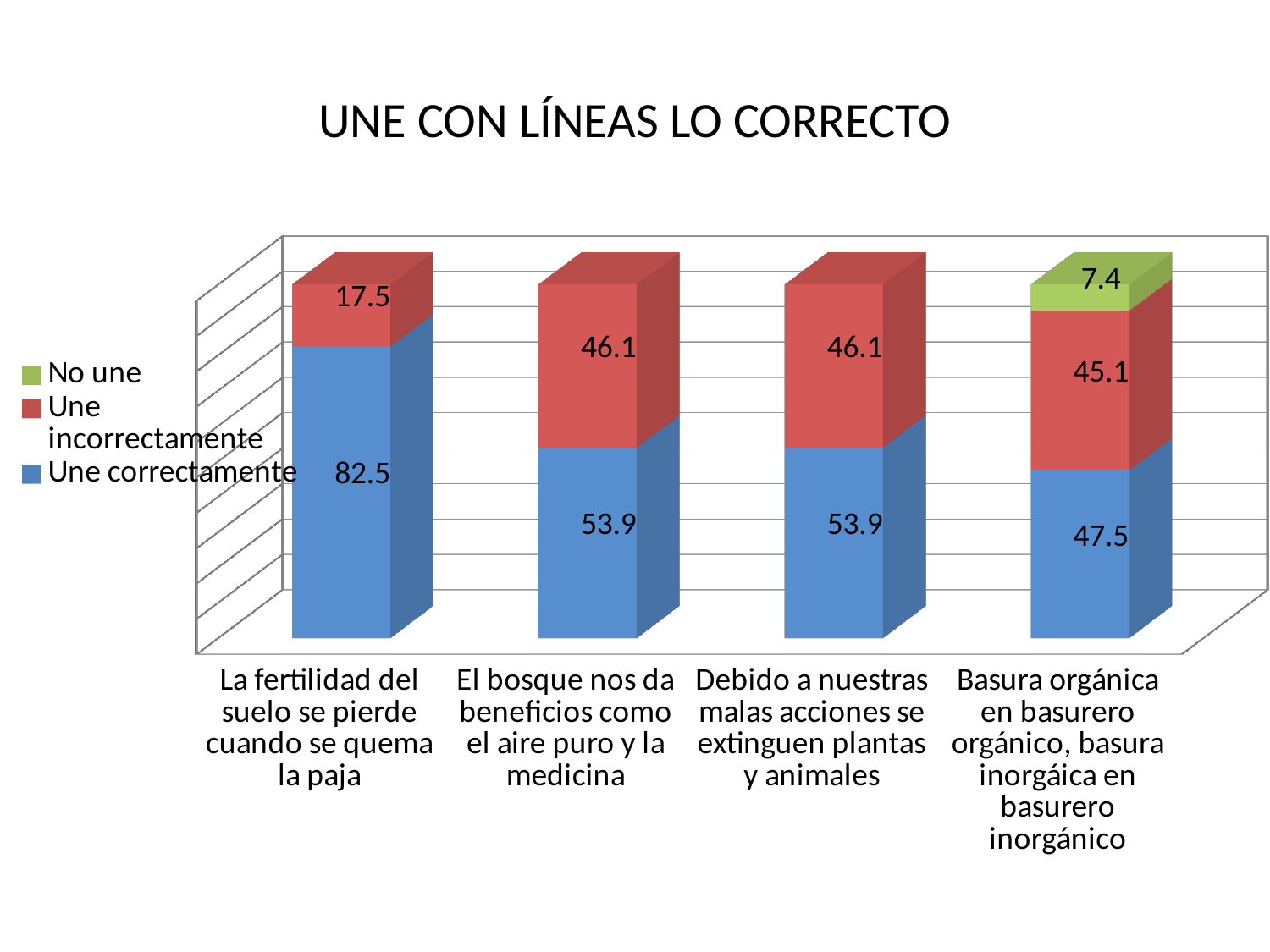
How many series does the legend list? 3 What is the value of "Une correctamente" for "La fertilidad del suelo se pierde cuando se quema la paja"? 82.5 What is the difference between "Une correctamente" and "Une incorrectamente" for "La fertilidad del suelo se pierde cuando se quema la paja"? 65 How many categories are shown on the x axis? 4 What is the value of "Une incorrectamente" for "El bosque nos da beneficios como el aire puro y la medicina"? 46.1 Which category has the highest value for "Une correctamente"? La fertilidad del suelo se pierde cuando se quema la paja What kind of chart is shown on the slide? Stacked bar chart What is the value of "Une correctamente" for "Debido a nuestras malas acciones se extinguen plantas y animales"? 53.9 What is the value of "No une" for "Basura orgánica en basurero orgánico, basura inorgáica en basurero inorgánico"? 7.4 What is the total of the stacked bar for "Basura orgánica en basurero orgánico, basura inorgáica en basurero inorgánico"? 100 Which is larger for "Basura orgánica en basurero orgánico, basura inorgáica en basurero inorgánico": "Une correctamente" or "Une incorrectamente"? Une correctamente Which category has the lowest value for "Une correctamente"? Basura orgánica en basurero orgánico, basura inorgáica en basurero inorgánico